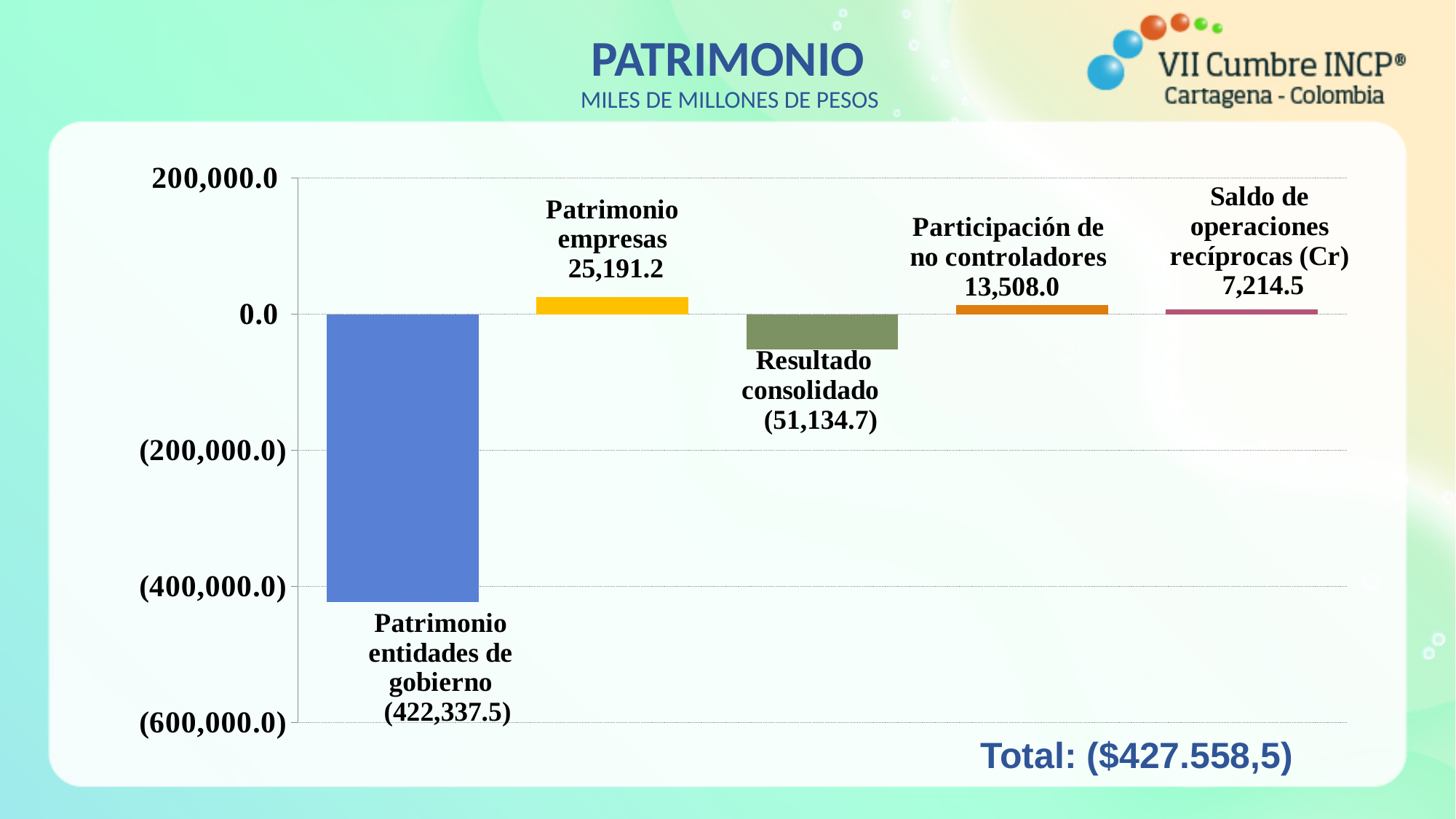
What is the value for Patrimonio empresas? 25,191.2 What is the value for Saldo de operaciones recíprocas (Cr)? 7,214.5 What is the value for Resultado consolidado? (51,134.7) How many categories are shown in the chart? 5 What is the difference between the values for Patrimonio empresas and Participación de no controladores? 11,683.2 What kind of chart is shown on the slide? Bar chart Which category has the highest value? Patrimonio empresas What total is shown below the chart? ($427.558,5) What is the value for Patrimonio entidades de gobierno? (422,337.5) Which category has the lowest value? Patrimonio entidades de gobierno What is the value for Participación de no controladores? 13,508.0 Which is larger, the value for Participación de no controladores or the value for Saldo de operaciones recíprocas (Cr)? Participación de no controladores